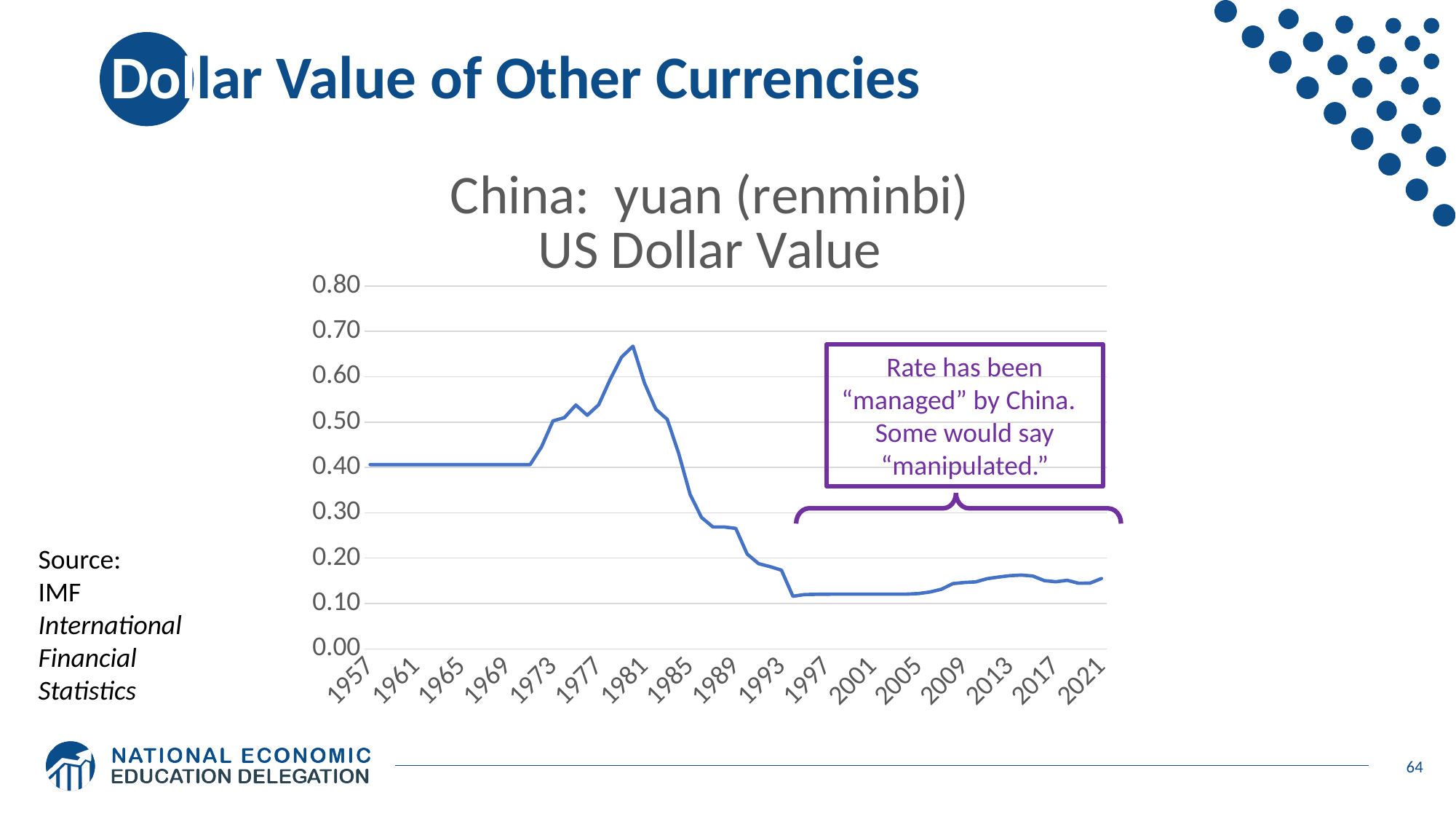
Is the value for 1997 greater or less than 0.10? greater Is the value for 2021 greater or less than 0.20? less Which year has the larger value, 1981 or 2021? 1981 What is the title of the chart? China: yuan (renminbi) US Dollar Value Around which labeled year does the line reach its highest value? 1981 Is the value for 1957 greater or less than 0.30? greater How many lines are plotted on the chart? 1 Does the value rise or fall between 1981 and 1993? fall What is the highest value shown on the y axis? 0.80 What type of chart is shown on the slide? line chart